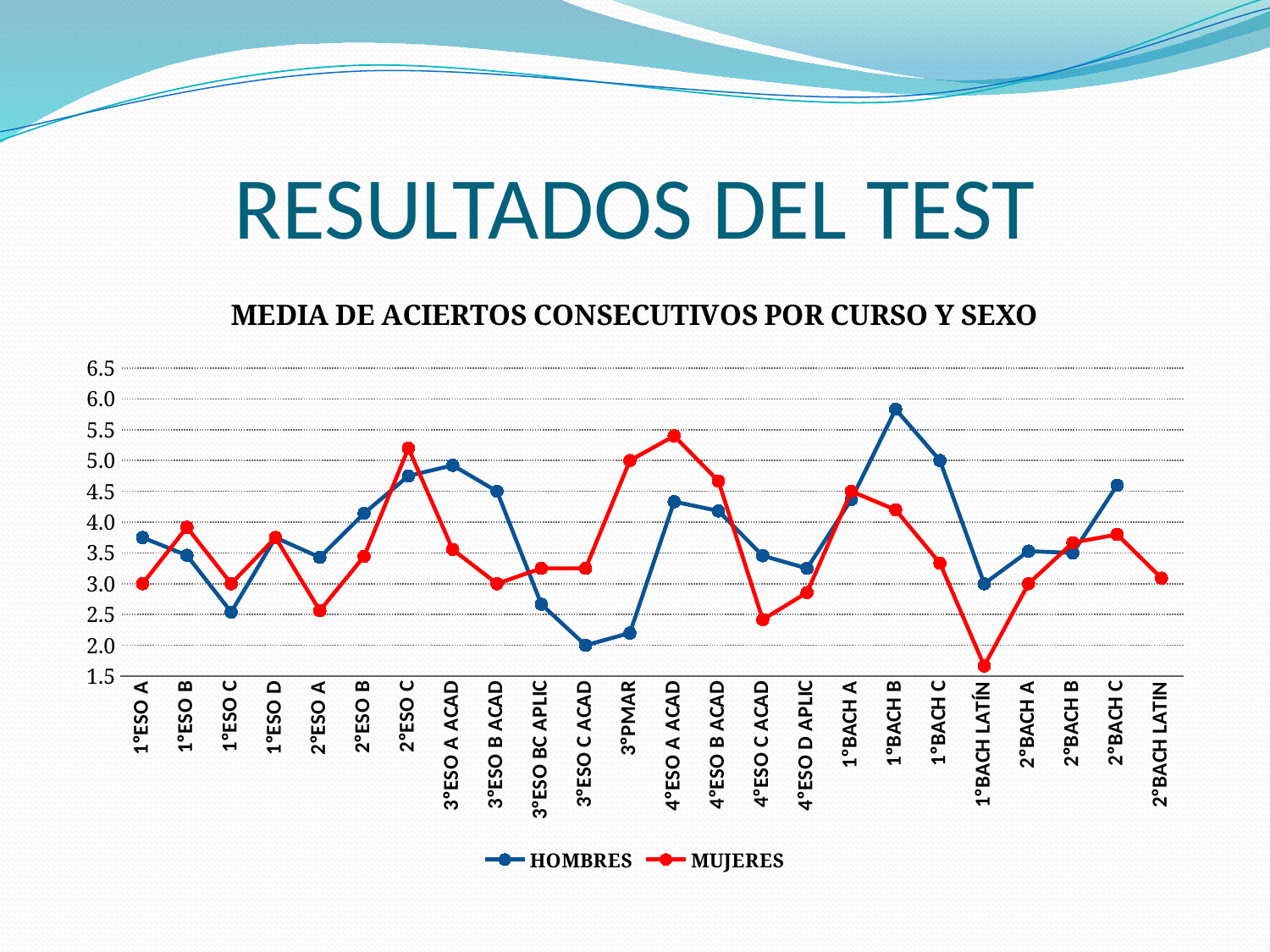
Is the MUJERES value for 1°BACH LATÍN greater or less than 2.0? less What is the MUJERES value for 3°PMAR? 5.0 What is the HOMBRES value for 1°BACH C? 5.0 At 3°PMAR, which series has the larger value, HOMBRES or MUJERES? MUJERES Which course has the lowest value for HOMBRES? 3°ESO C ACAD How many series does the legend list? 2 Which course has the lowest value for MUJERES? 1°BACH LATÍN Is the HOMBRES value for 1°BACH B greater or less than 5.5? greater What is the title of the chart? MEDIA DE ACIERTOS CONSECUTIVOS POR CURSO Y SEXO How many course categories are plotted along the x axis? 24 Which course has the highest value for HOMBRES? 1°BACH B What kind of chart is shown on the slide? Line chart